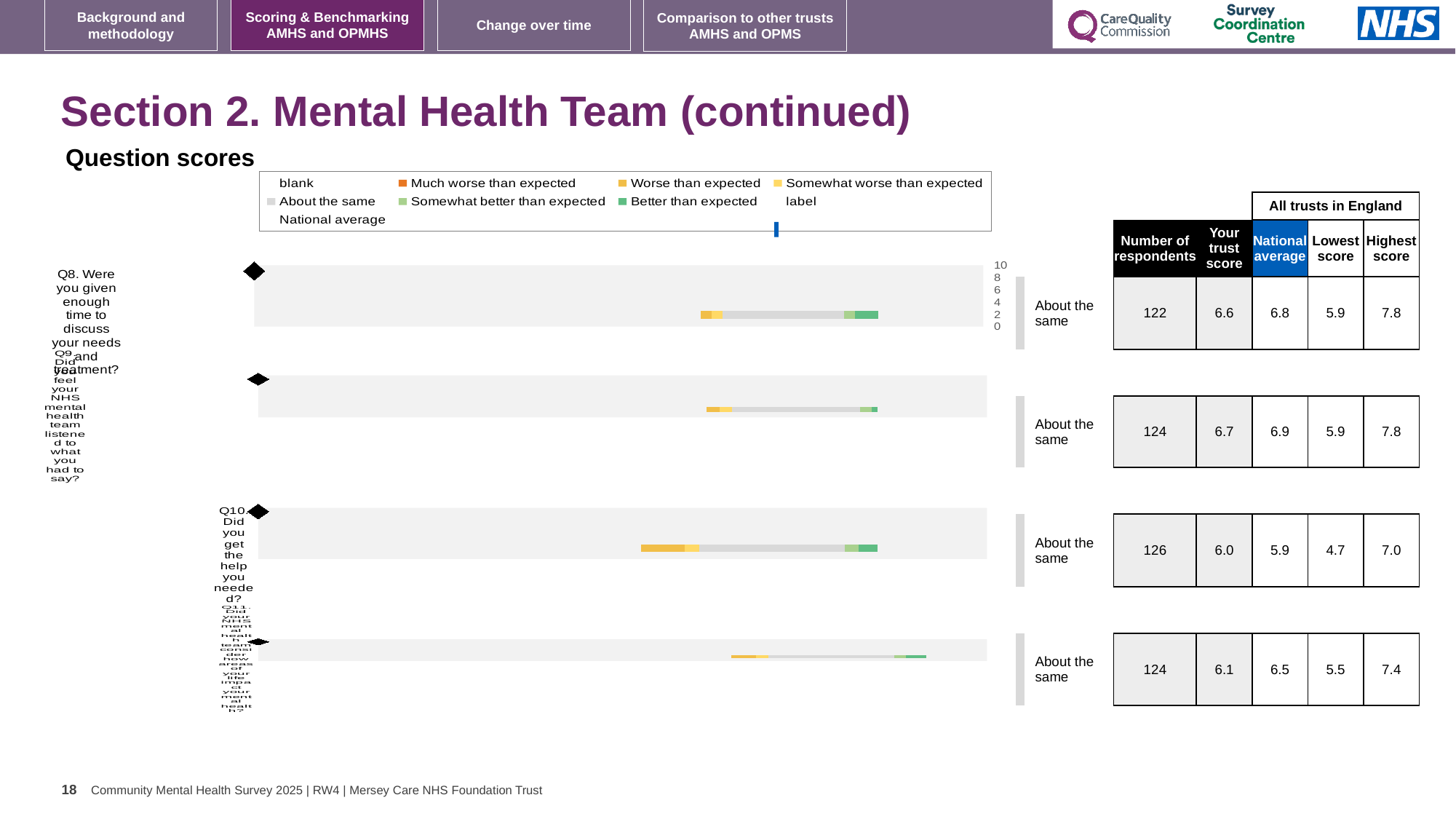
What colour does the legend use for 'Better than expected'? green In the table next to the charts, what is the 'Your trust score' for Q8 (Were you given enough time to discuss your needs and treatment?)? 6.6 What benchmark category label is shown beside the Q9 bar? About the same Which question has the lowest 'Lowest score' value in the table next to the charts? Q10 What kind of chart is used to show the question scores for Q8 to Q11? bar chart In the table next to the charts, what is the National average for Q10 (Did you get the help you needed?)? 5.9 Which question has the highest number of respondents in the table next to the charts? Q10 How many questions (Q8 to Q11) have a score bar plotted on the slide? 4 In the table next to the charts, what is the Highest score across all trusts in England for Q8? 7.8 In the table next to the charts, how many respondents answered Q9? 124 For Q10, is Your trust score or the National average larger in the table next to the charts? Your trust score What is the difference between the National average and Your trust score for Q8 in the table next to the charts? 0.2